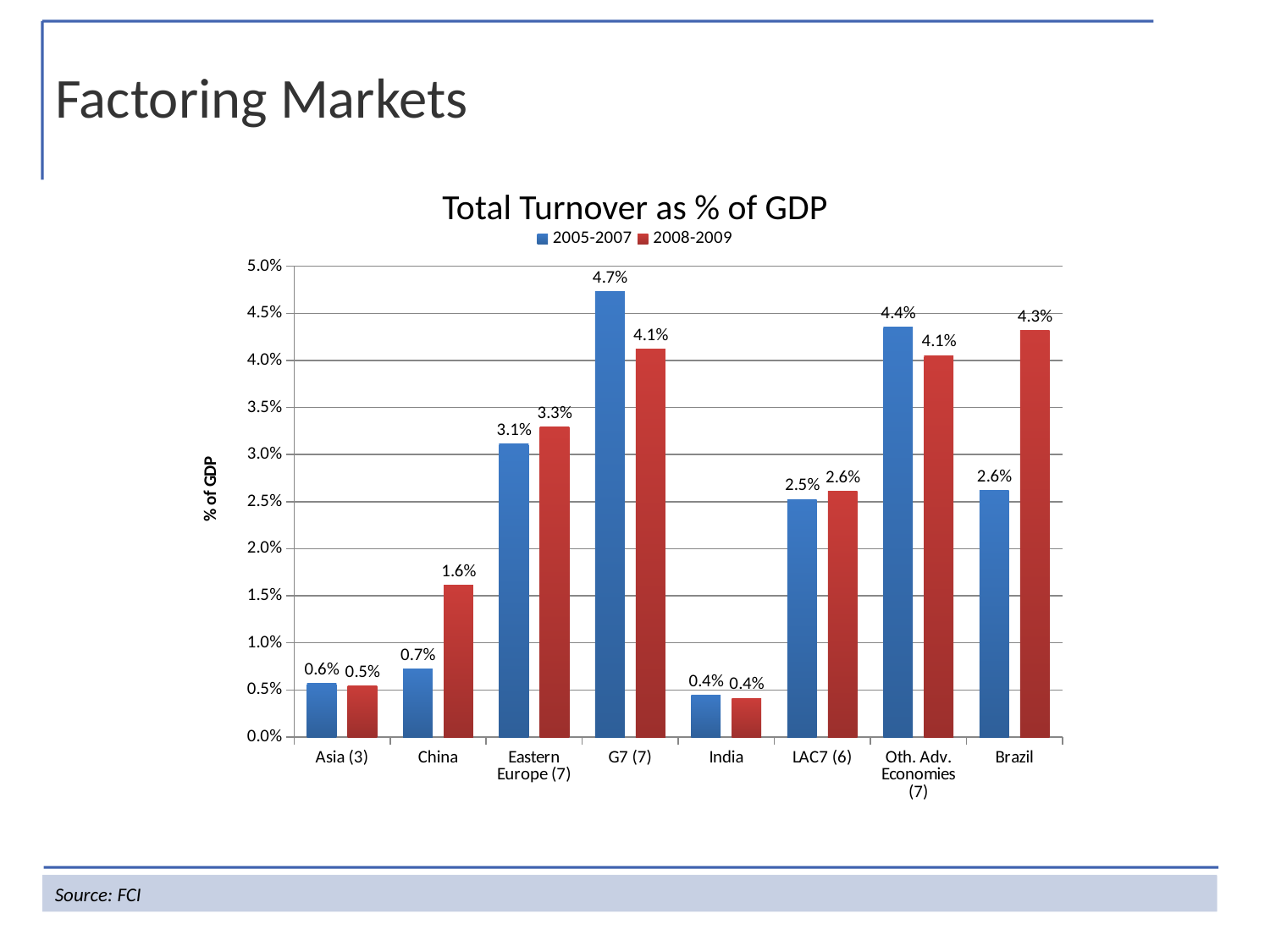
Which category has the lowest 2005-2007 value? India Which category has the highest 2005-2007 value? G7 (7) What type of chart is shown? Bar chart Which is larger for Oth. Adv. Economies (7): the 2005-2007 value or the 2008-2009 value? 2005-2007 Which category has the highest 2008-2009 value? Brazil What is the 2008-2009 value for China? 1.6% What is the difference between the 2008-2009 and 2005-2007 values for Brazil? 1.7 percentage points How many categories are shown on the x axis? 8 What is the 2008-2009 value for Brazil? 4.3% What is the difference between the 2005-2007 and 2008-2009 values for G7 (7)? 0.6 percentage points What is the 2005-2007 value for G7 (7)? 4.7% How many series does the legend list? 2